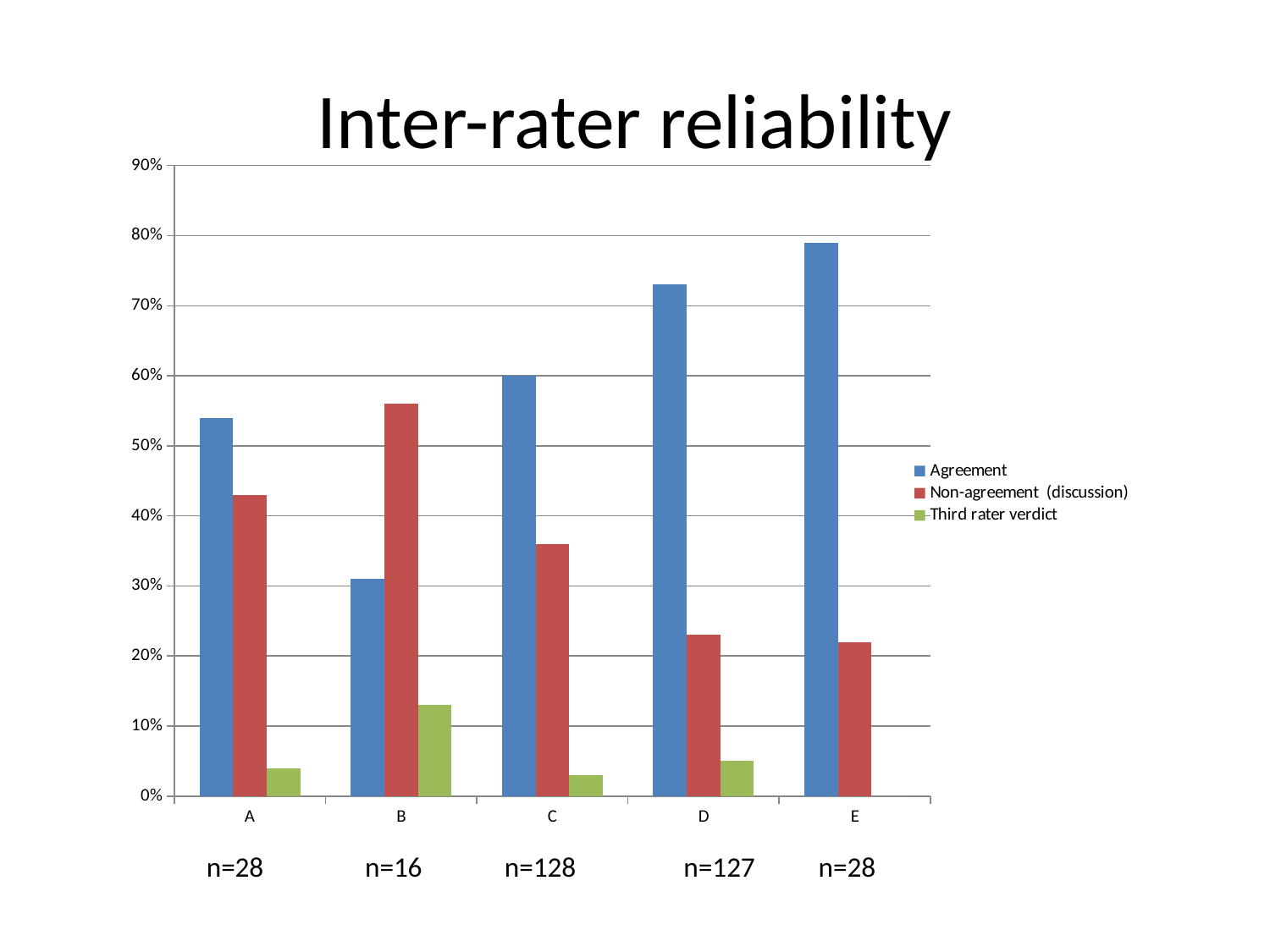
Which category has the highest Non-agreement (discussion) value? B What kind of chart is shown on the slide? bar chart Which is larger for category B, Agreement or Non-agreement (discussion)? Non-agreement (discussion) Is the Third rater verdict value for B greater or less than 10%? greater How many categories are shown on the x axis? 5 Is the Non-agreement (discussion) value for A greater or less than 40%? greater Is the Agreement value for D greater or less than 70%? greater What is the title of the chart? Inter-rater reliability Which category has the highest Agreement value? E Which category has the lowest Agreement value? B Which category has the highest Third rater verdict value? B How many series does the legend list? 3